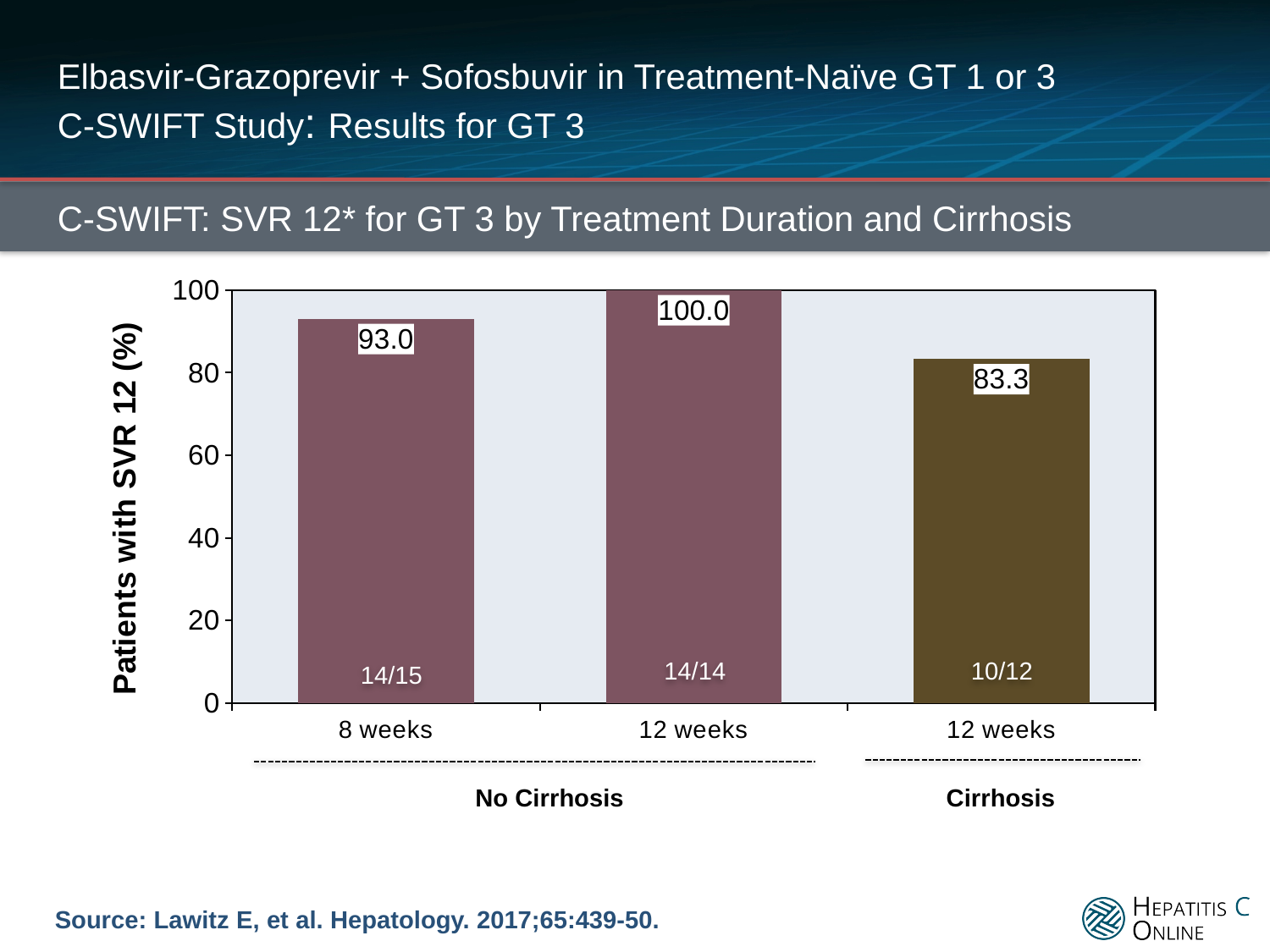
What is the label of the y-axis? Patients with SVR 12 (%) How many bars are shown in the chart? 3 What is the difference in SVR 12 rate between the 12 weeks No Cirrhosis group and the 12 weeks Cirrhosis group? 16.7 What fraction of patients achieved SVR 12 in the 12 weeks, Cirrhosis group? 10/12 What fraction of patients achieved SVR 12 in the 8 weeks, No Cirrhosis group? 14/15 Which group has the lowest SVR 12 rate? 12 weeks, Cirrhosis Which group has the highest SVR 12 rate? 12 weeks, No Cirrhosis Which has a higher SVR 12 rate: 8 weeks No Cirrhosis or 12 weeks Cirrhosis? 8 weeks No Cirrhosis What is the SVR 12 rate for the 8 weeks, No Cirrhosis group? 93.0 What type of chart is shown on the slide? Bar chart What is the SVR 12 rate for the 12 weeks, Cirrhosis group? 83.3 What is the SVR 12 rate for the 12 weeks, No Cirrhosis group? 100.0